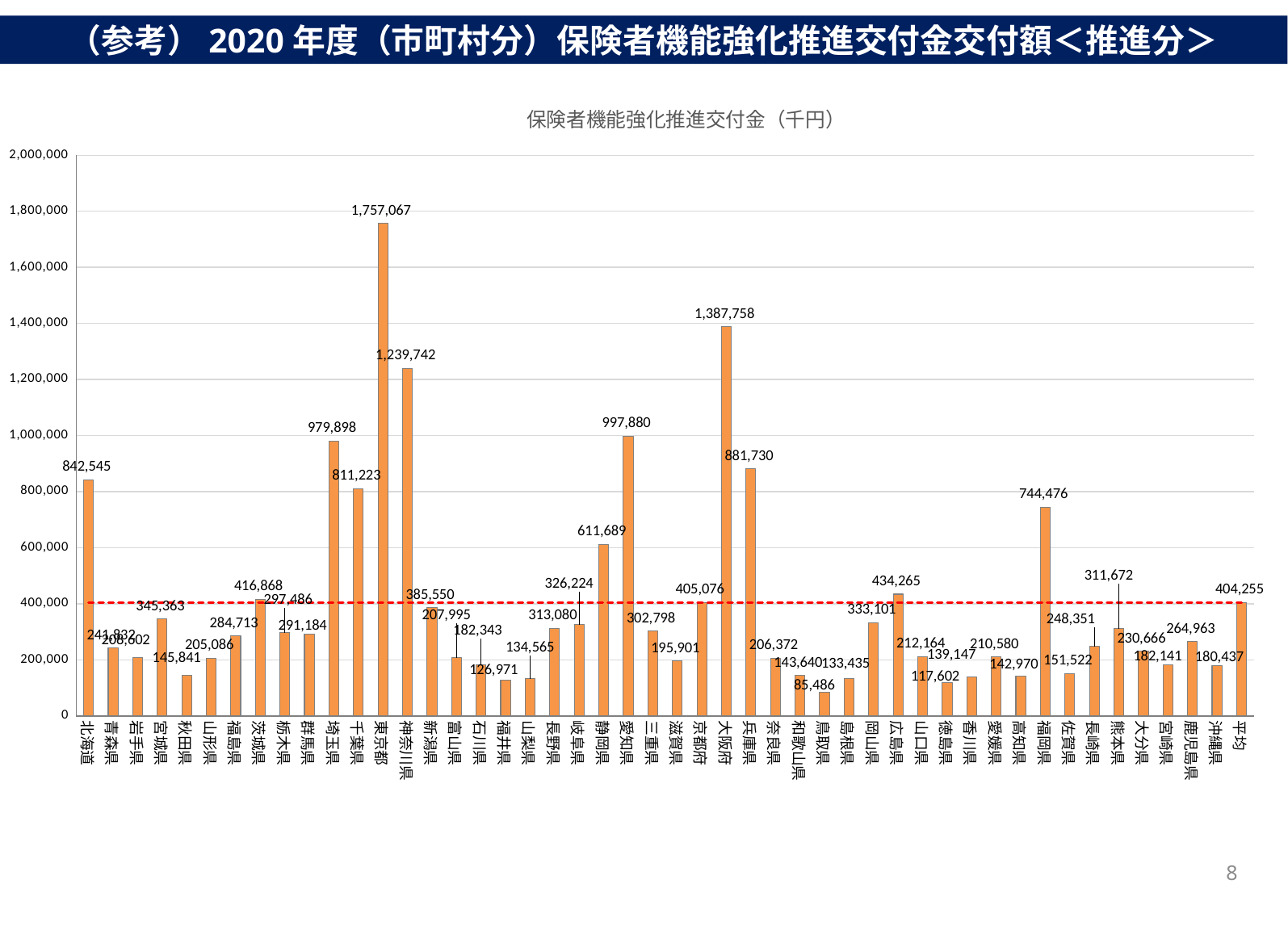
Which category has the highest value? 東京都 Which category has the lowest value? 鳥取県 What is the title of the chart? 保険者機能強化推進交付金（千円） Is the value for 静岡県 greater or less than 400,000? greater How many bars are plotted in the chart? 48 What is the value for 東京都? 1,757,067 What is the value for 大阪府? 1,387,758 What is the value for 福岡県? 744,476 What is the difference between the values for 東京都 and 大阪府? 369,309 What is the value shown for 平均? 404,255 Which is larger, the value for 愛知県 or the value for 埼玉県? 愛知県 What kind of chart is shown on the slide? bar chart